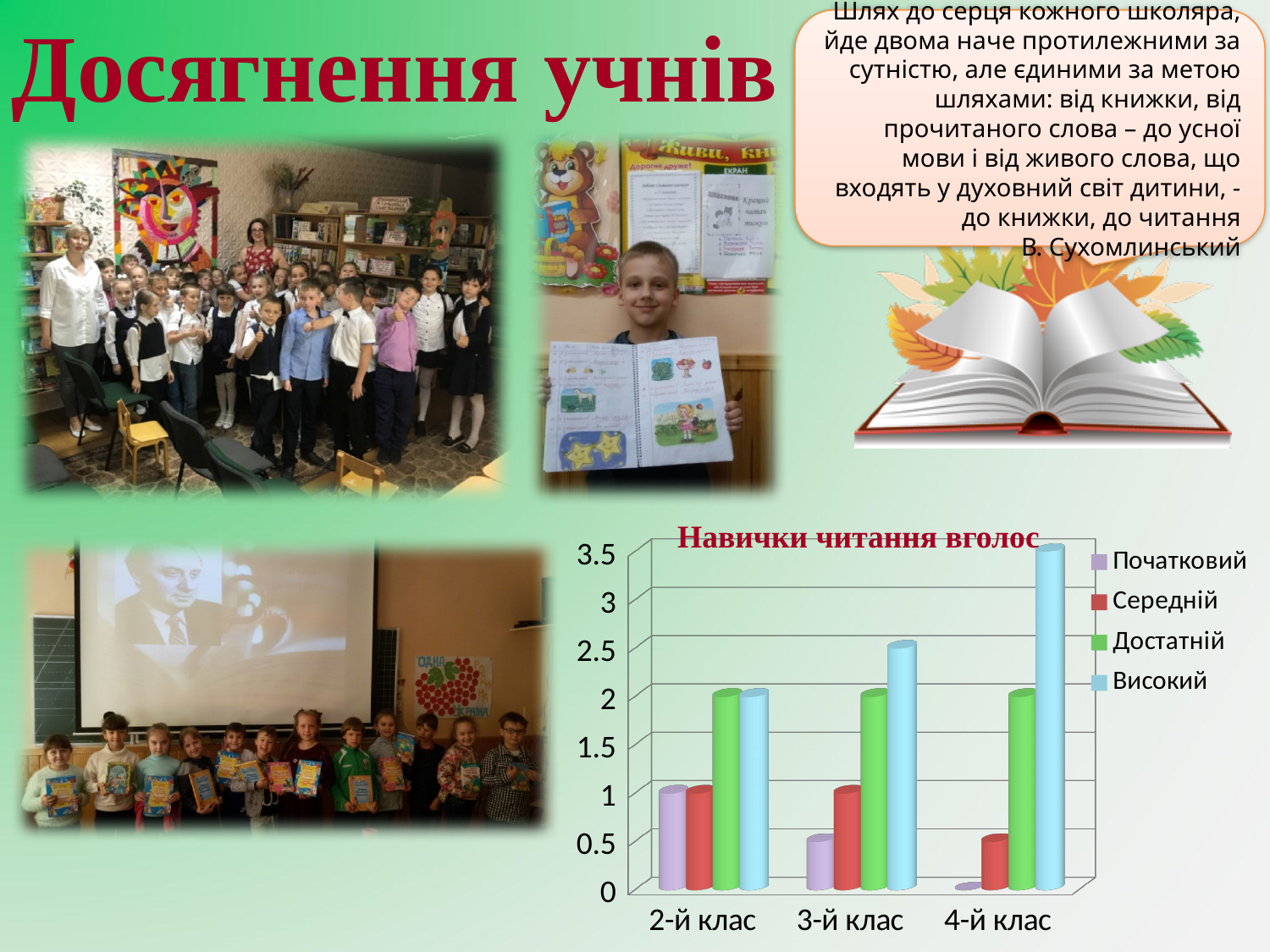
Which class has the lowest value for the Початковий series? 4-й клас Is the value of Високий for 4-й клас greater or less than 3? greater Is the value of Початковий for 3-й клас greater or less than 1? less What kind of chart is shown on the slide? bar chart What is the title of the chart? Навички читання вголос How many series does the chart legend list? 4 Does the Високий series rise or fall from 2-й клас to 4-й клас? rise Is the value of Середній for 4-й клас greater or less than 1? less Which series has the highest value for 4-й клас? Високий Which class has the highest value for the Високий series? 4-й клас For 3-й клас, which is larger: Високий or Середній? Високий How many classes (categories) are shown on the x axis of the chart? 3